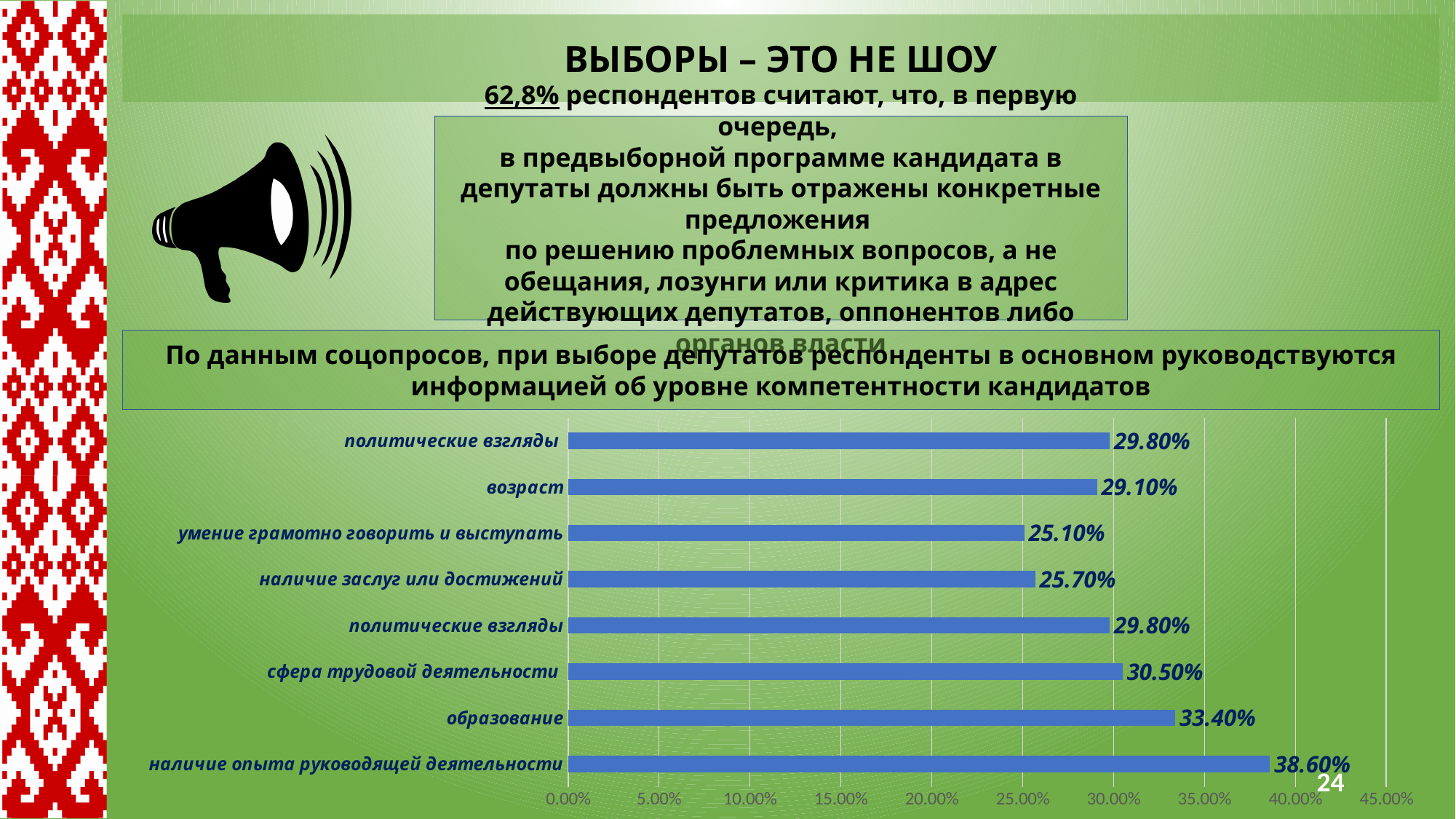
What is the value for "сфера трудовой деятельности"? 30.50% Which category has the lowest value? умение грамотно говорить и выступать What is the value for "наличие опыта руководящей деятельности"? 38.60% What is the difference between the values for "наличие опыта руководящей деятельности" and "образование"? 5.20% What is the value for "образование"? 33.40% How many bars does the chart contain? 8 What is the value for "умение грамотно говорить и выступать"? 25.10% What type of chart is shown on the slide? bar chart What is the value for "возраст"? 29.10% Which is larger, the value for "образование" or the value for "сфера трудовой деятельности"? образование Which category has the highest value? наличие опыта руководящей деятельности Is the value for "наличие опыта руководящей деятельности" greater or less than 35.00%? greater